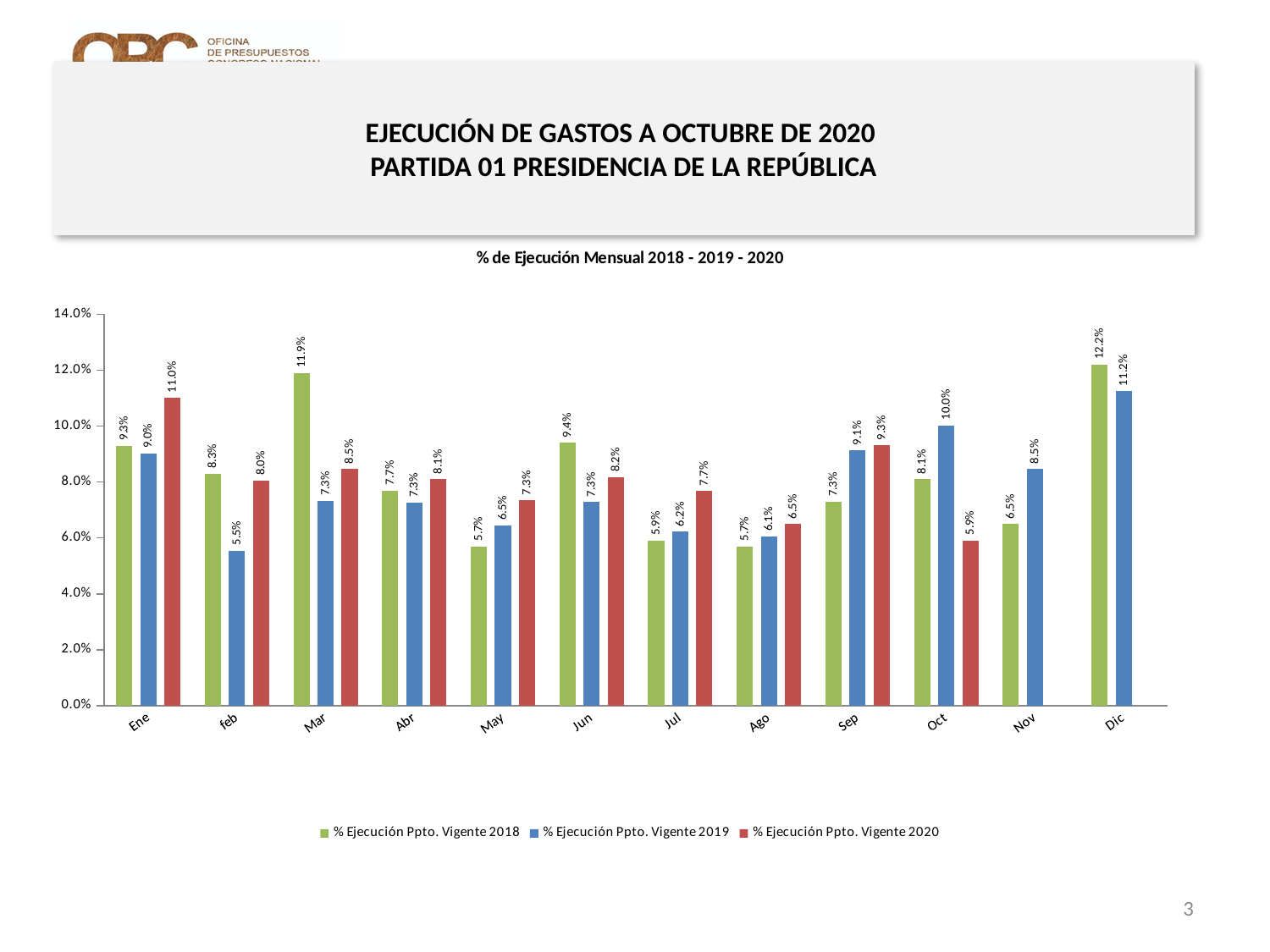
What is the value for % Ejecución Ppto. Vigente 2018 in Mar? 11.9% Which month has the lowest value for % Ejecución Ppto. Vigente 2019? feb What is the value for % Ejecución Ppto. Vigente 2020 in Ene? 11.0% What is the value for % Ejecución Ppto. Vigente 2019 in Oct? 10.0% What kind of chart is this? bar chart What is the difference between the 2018 and 2019 values in Mar? 4.6 percentage points How many months are shown on the x axis? 12 Is the value for % Ejecución Ppto. Vigente 2018 in Dic greater or less than 10.0%? greater Which month has the highest value for % Ejecución Ppto. Vigente 2018? Dic How many series does the legend list? 3 Which month has the highest value for % Ejecución Ppto. Vigente 2020? Ene In Oct, which is larger: the 2019 value or the 2020 value? 2019